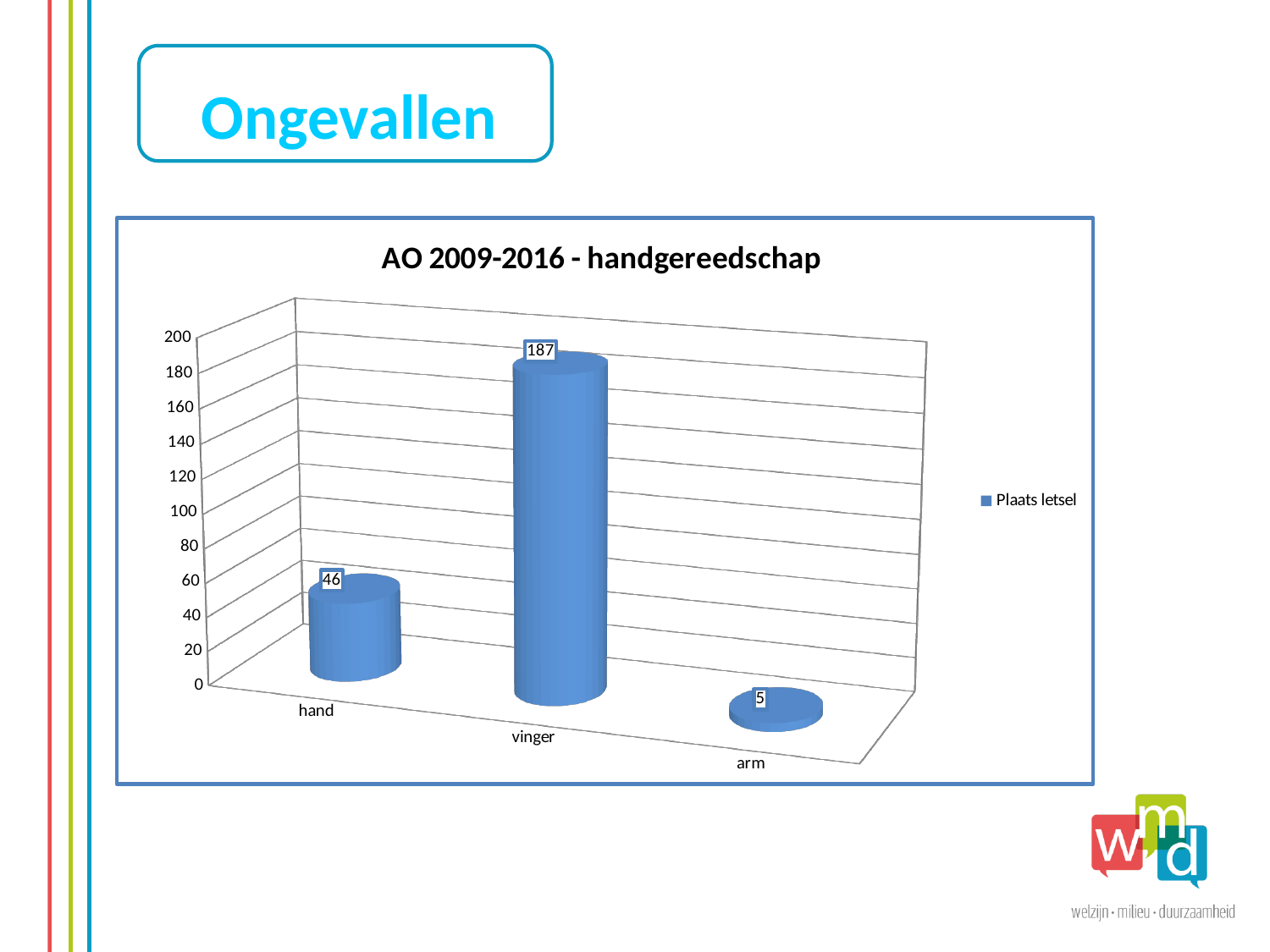
How many categories are shown on the x axis? 3 What is the title of the chart? AO 2009-2016 - handgereedschap What is the value for vinger? 187 Which is larger, the value for hand or the value for arm? hand What is the difference between the values for hand and arm? 41 What is the value for arm? 5 What is the difference between the values for vinger and hand? 141 What is the value for hand? 46 Which category has the highest value? vinger What kind of chart is shown? bar chart Which category has the lowest value? arm Is the value for vinger greater or less than 100? greater